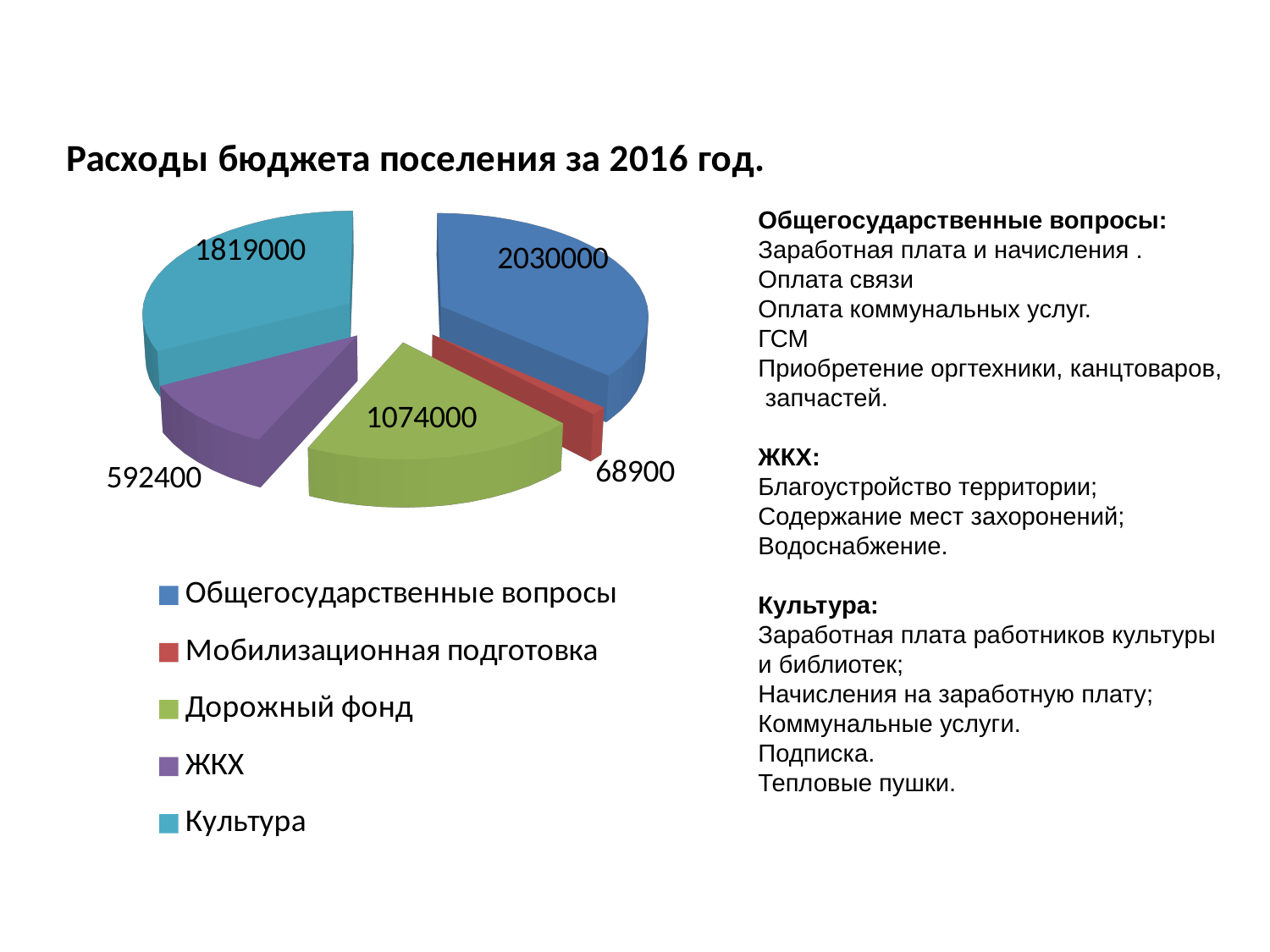
What is the value for Дорожный фонд? 1074000 What colour is the slice for Мобилизационная подготовка? Red What is the value for Общегосударственные вопросы? 2030000 What is the title of the chart? Расходы бюджета поселения за 2016 год. What type of chart is shown on the slide? Pie chart What is the value for Культура? 1819000 How many categories does the legend list? 5 Which category has the smallest slice? Мобилизационная подготовка What is the difference between the values for Общегосударственные вопросы and Культура? 211000 Which category has the largest slice? Общегосударственные вопросы What is the value for ЖКХ? 592400 Which is larger, Дорожный фонд or ЖКХ? Дорожный фонд